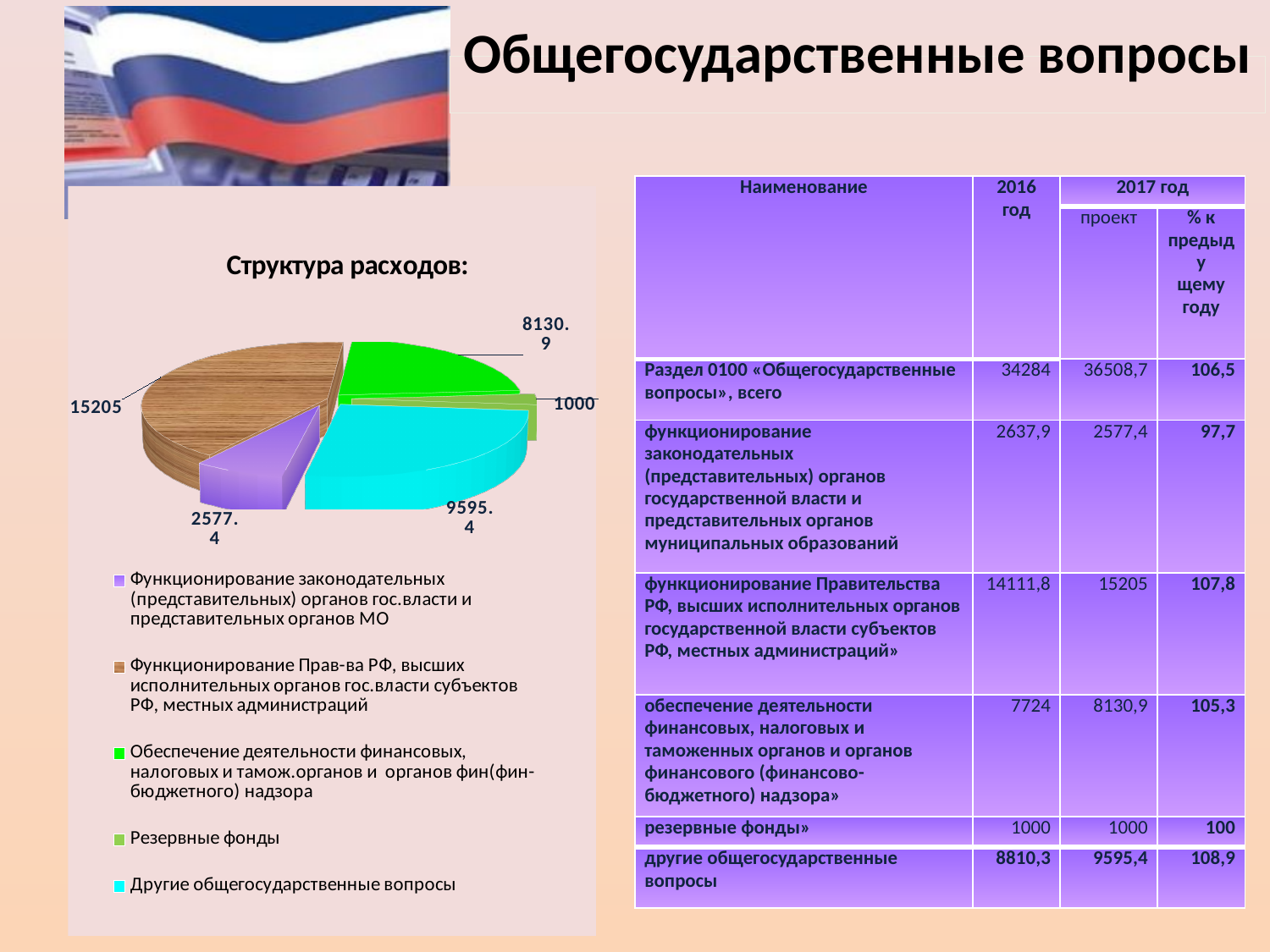
What is the title of the pie chart on the slide? Структура расходов: In the pie chart, what is the difference between the "Функционирование Прав-ва РФ..." slice (15205) and the "Другие общегосударственные вопросы" slice (9595.4)? 5609.6 What is the value of the "Функционирование Прав-ва РФ, высших исполнительных органов гос.власти субъектов РФ, местных администраций" slice in the pie chart? 15205 Which slice of the pie chart "Структура расходов:" is the smallest? Резервные фонды What is the value of the "Другие общегосударственные вопросы" slice in the pie chart? 9595.4 How many entries does the legend of the pie chart list? 5 What is the value of the "Функционирование законодательных (представительных) органов гос.власти и представительных органов МО" slice in the pie chart? 2577.4 In the pie chart, which is larger: "Обеспечение деятельности финансовых, налоговых и тамож.органов и органов фин(фин-бюджетного) надзора" or "Другие общегосударственные вопросы"? Другие общегосударственные вопросы Which slice of the pie chart "Структура расходов:" is the largest? Функционирование Прав-ва РФ, высших исполнительных органов гос.власти субъектов РФ, местных администраций How many slices does the pie chart "Структура расходов:" have? 5 What is the value of the "Резервные фонды" slice in the pie chart? 1000 What kind of chart is shown under the title "Структура расходов:"? pie chart